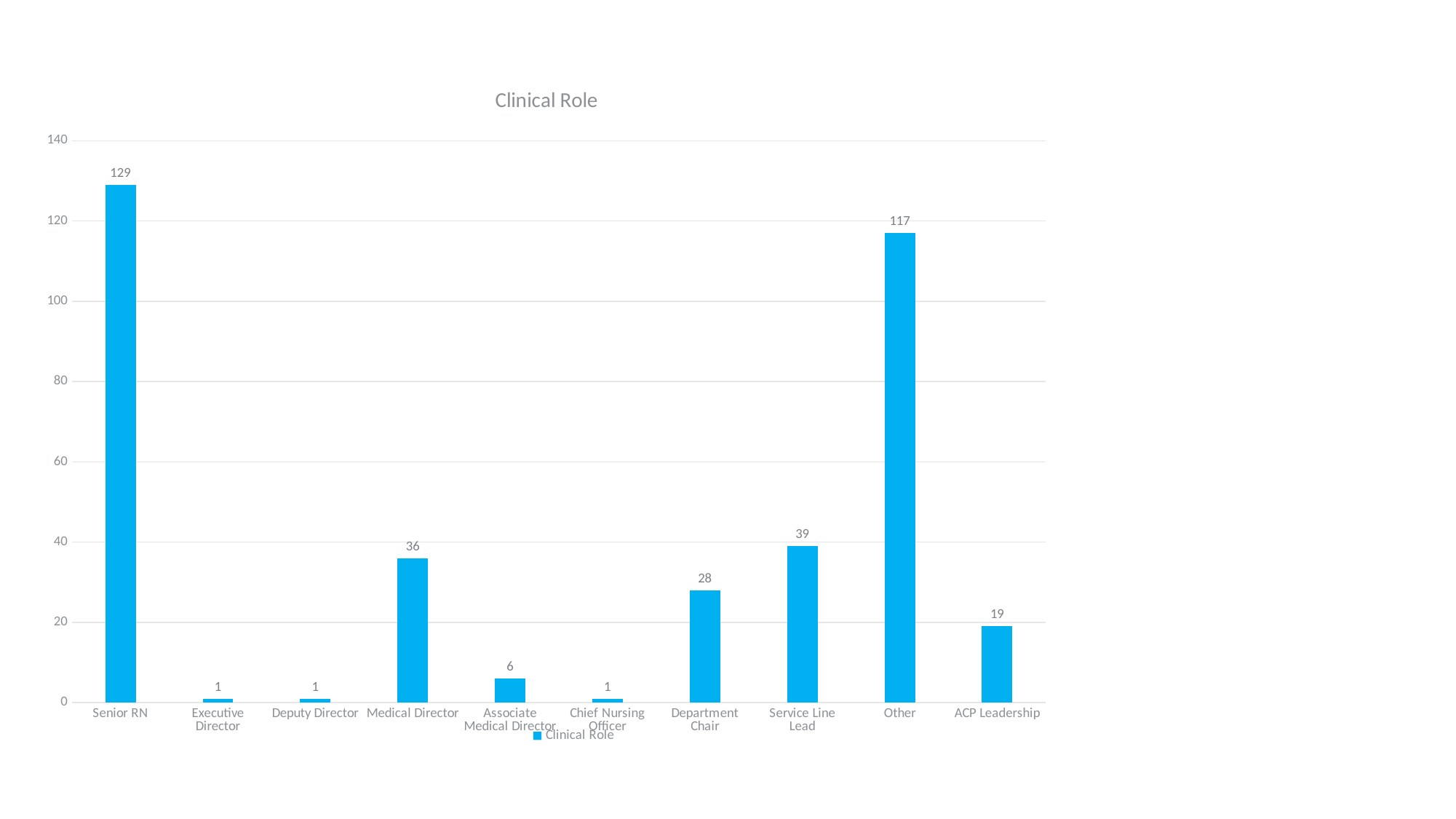
Is the value for Other greater or less than 100? greater What kind of chart is shown? Bar chart What is the difference between the values for Service Line Lead and Medical Director? 3 What is the value for Service Line Lead? 39 How many categories are shown on the x axis? 10 Which is larger, the value for Department Chair or the value for Medical Director? Medical Director Which category has the highest value? Senior RN What is the value for ACP Leadership? 19 What is the difference between the values for Senior RN and Other? 12 How many series does the legend list? 1 What is the value for Senior RN? 129 What is the title of the chart? Clinical Role